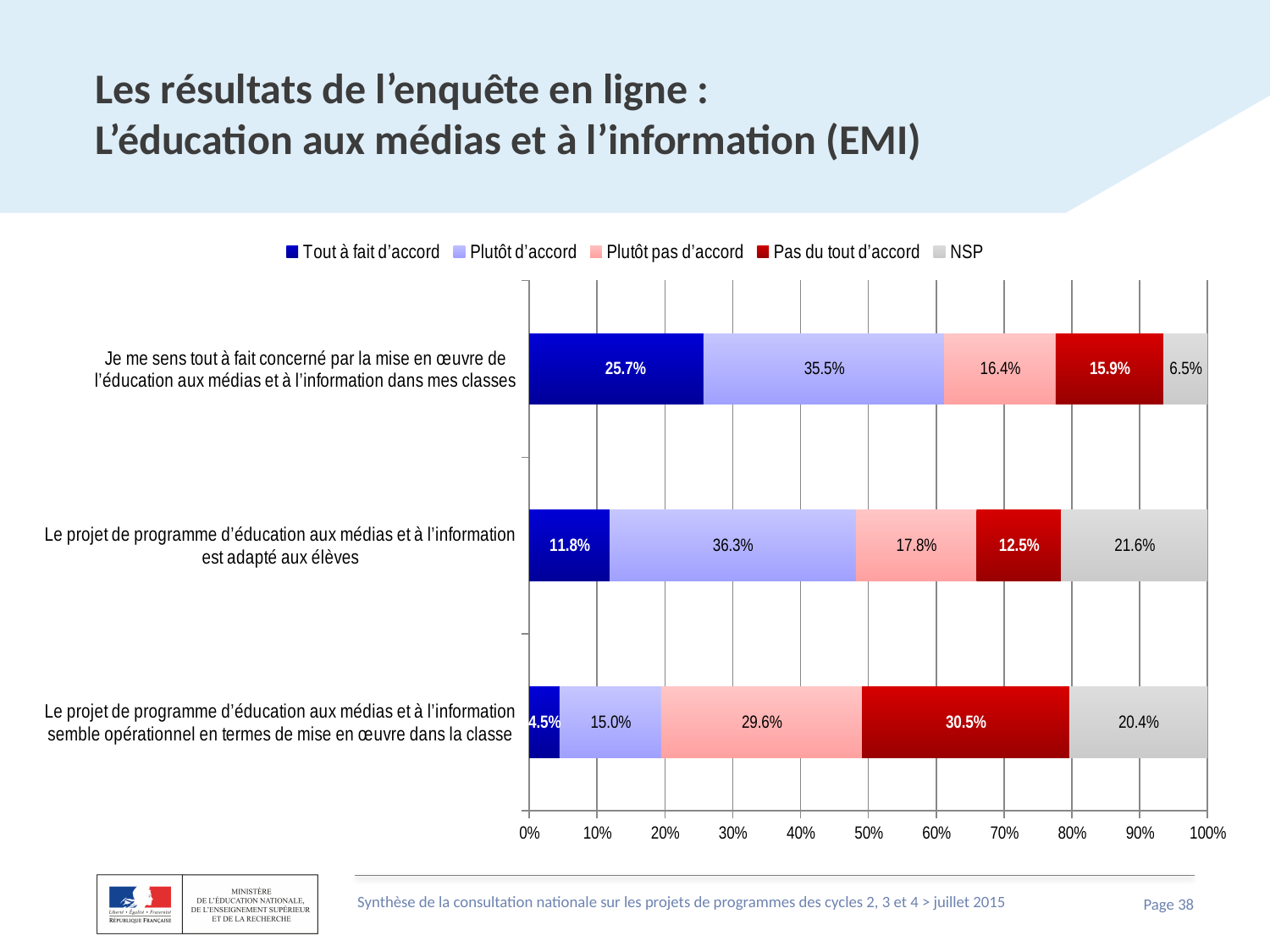
What kind of chart is shown on the slide? Stacked bar chart What is the total of the stacked bar for 'Le projet de programme d'éducation aux médias et à l'information est adapté aux élèves'? 100.0% What is the difference between the 'Plutôt pas d'accord' values for 'semble opérationnel en termes de mise en œuvre dans la classe' and 'est adapté aux élèves'? 11.8% How many statements (categories) are plotted in the chart? 3 Which is larger: the 'NSP' value for 'Je me sens tout à fait concerné...' or the 'NSP' value for 'Le projet de programme ... est adapté aux élèves'? Le projet de programme ... est adapté aux élèves What is the 'NSP' value for 'Le projet de programme d'éducation aux médias et à l'information est adapté aux élèves'? 21.6% Which statement has the lowest 'Tout à fait d'accord' value? Le projet de programme d'éducation aux médias et à l'information semble opérationnel en termes de mise en œuvre dans la classe Which statement has the highest 'Plutôt d'accord' value? Le projet de programme d'éducation aux médias et à l'information est adapté aux élèves What is the 'Tout à fait d'accord' value for 'Je me sens tout à fait concerné par la mise en œuvre de l'éducation aux médias et à l'information dans mes classes'? 25.7% How many series does the legend list? 5 What is the 'Pas du tout d'accord' value for 'Le projet de programme d'éducation aux médias et à l'information semble opérationnel en termes de mise en œuvre dans la classe'? 30.5% Which legend entry is shown in dark red? Pas du tout d'accord